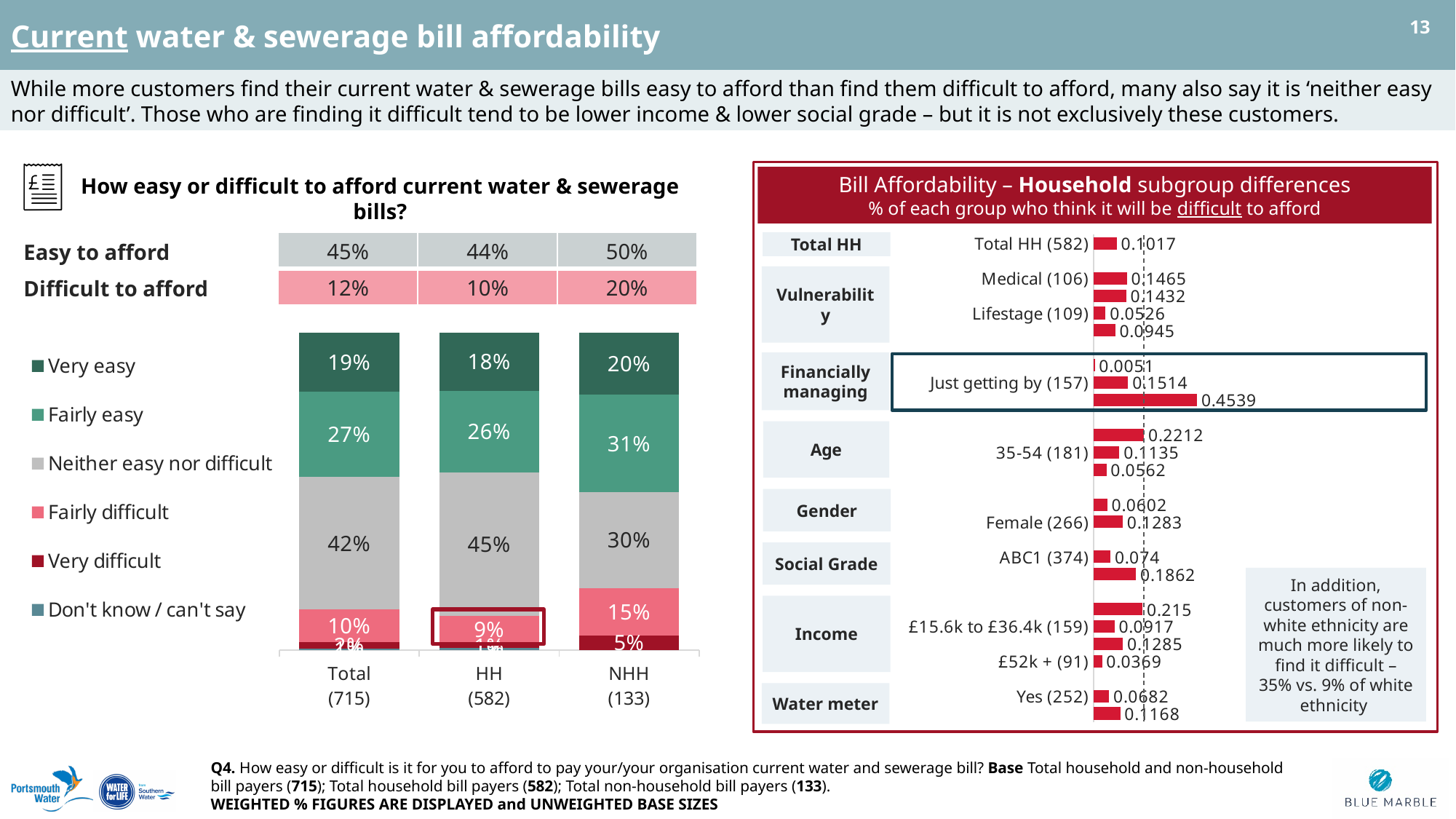
What type of chart is the 'Bill Affordability – Household subgroup differences' chart on the right? Bar chart How many bars (groups) are shown in the stacked bar chart on the left? 3 In the left chart, what is the difference between the 'Easy to afford' percentage for NHH and for HH? 6% In the 'Bill Affordability – Household subgroup differences' chart, what is the value for £52k + (91)? 0.0369 In the stacked bar chart on the left, is the 'Neither easy nor difficult' share larger for Total or for NHH? Total In the stacked bar chart on the left, what percentage of NHH (133) respondents said 'Fairly easy'? 31% In the stacked bar chart on the left, what percentage of HH (582) respondents said 'Neither easy nor difficult'? 45% In the stacked bar chart on the left, what percentage of Total (715) respondents said 'Very easy'? 19% In the 'Bill Affordability – Household subgroup differences' chart, is the value for Medical (106) larger or smaller than the value for Total HH (582)? Larger In the left chart, which group has the highest 'Difficult to afford' percentage: Total, HH or NHH? NHH In the 'Bill Affordability – Household subgroup differences' chart, what is the value for Just getting by (157)? 0.1514 How many series does the legend of the stacked bar chart on the left list? 6